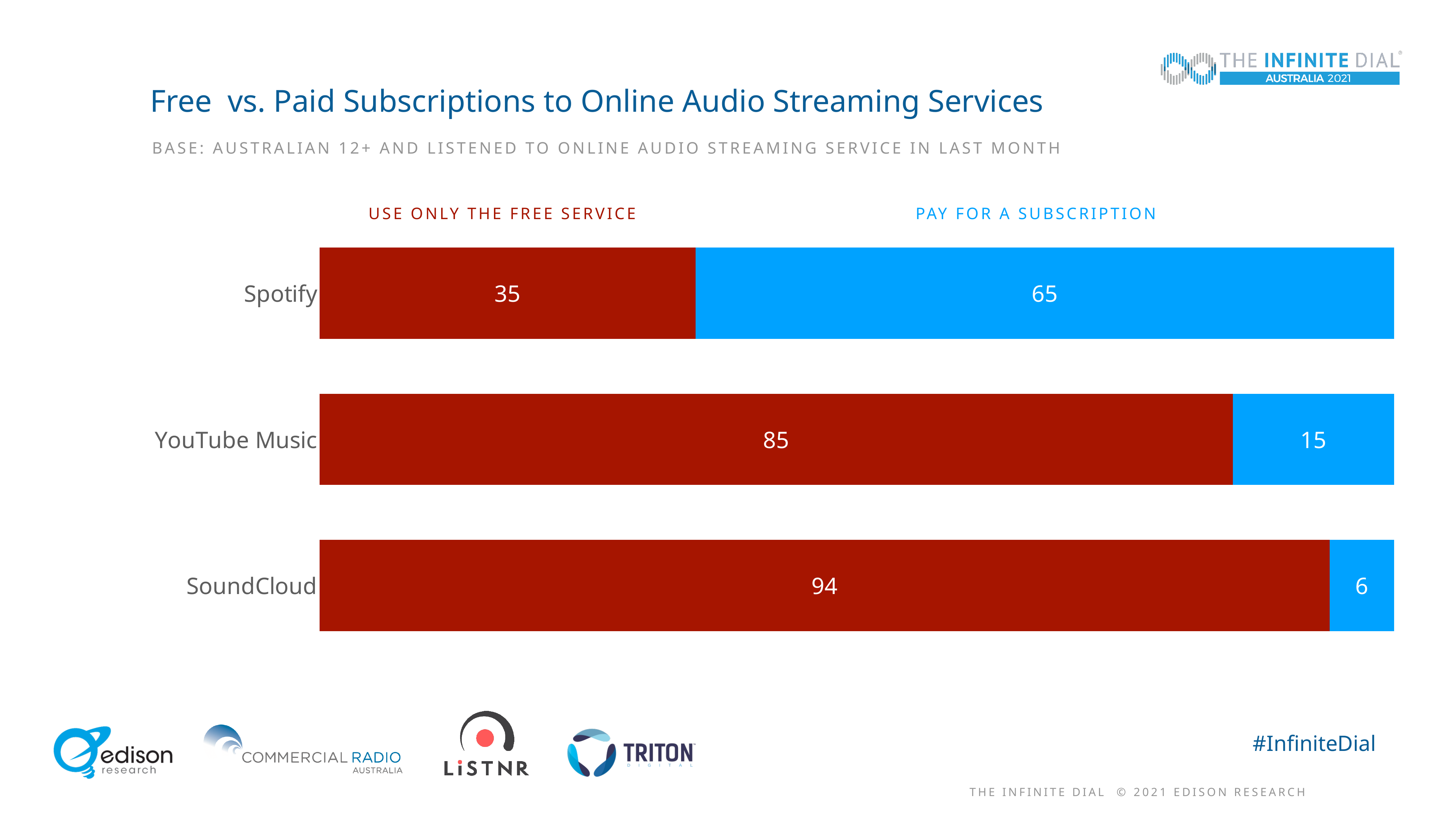
How many services are shown in the chart? 3 Which service has the highest value for 'Pay for a subscription'? Spotify Which is larger: the 'Pay for a subscription' value for YouTube Music or for SoundCloud? YouTube Music What is the value for YouTube Music in the 'Pay for a subscription' series? 15 What is the total of the stacked bar for YouTube Music? 100 Which service has the lowest value for 'Use only the free service'? Spotify What is the value for Spotify in the 'Use only the free service' series? 35 What is the value for Spotify in the 'Pay for a subscription' series? 65 How many series does the chart show? 2 What is the difference between the 'Use only the free service' values for SoundCloud and YouTube Music? 9 What is the value for SoundCloud in the 'Use only the free service' series? 94 What kind of chart is shown on the slide? Stacked bar chart